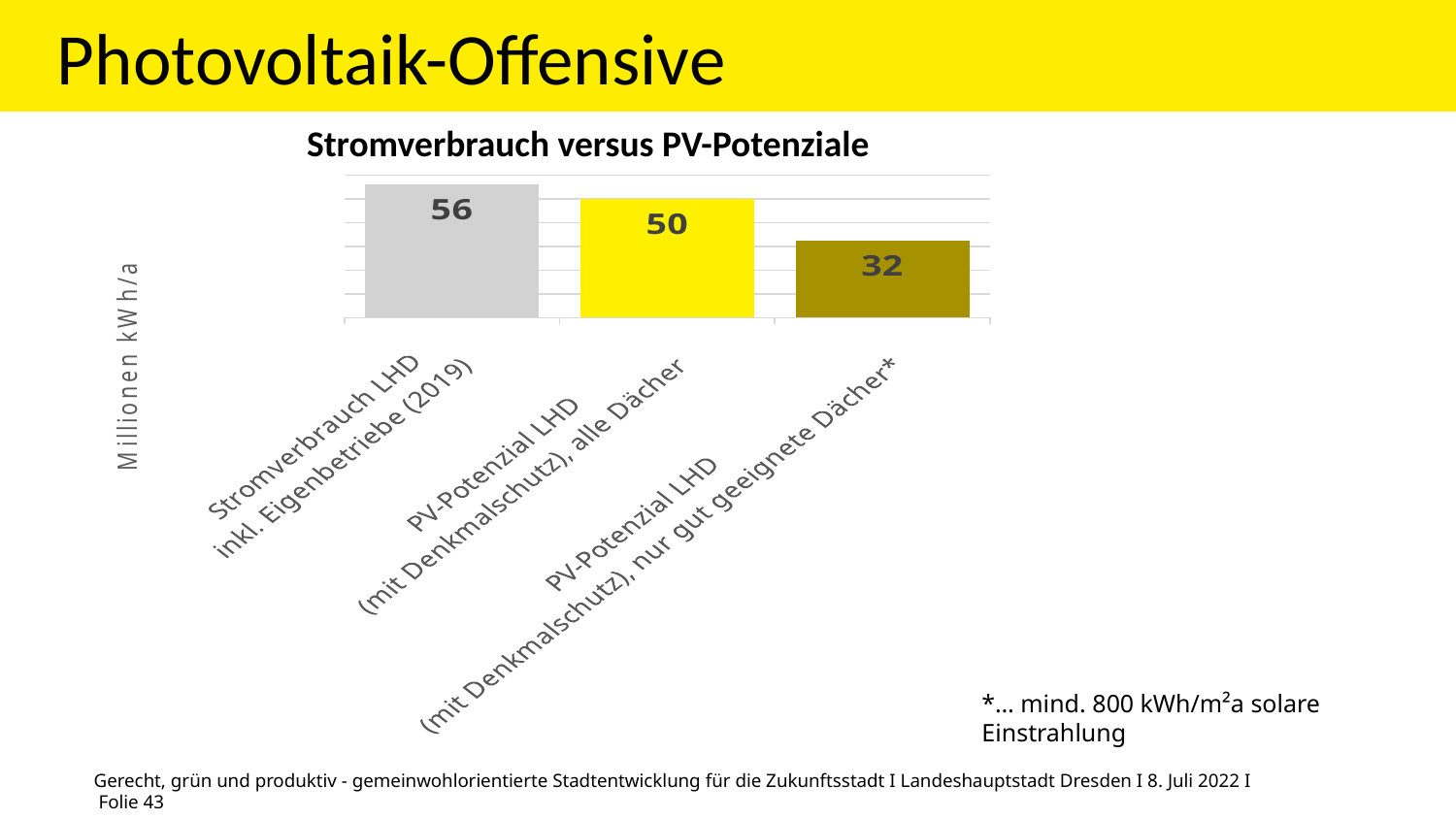
Which category has the lowest value? PV-Potenzial LHD (mit Denkmalschutz), nur gut geeignete Dächer* What is the difference between the value for 'PV-Potenzial LHD (mit Denkmalschutz), alle Dächer' and the value for 'PV-Potenzial LHD (mit Denkmalschutz), nur gut geeignete Dächer*'? 18 What is the value for 'PV-Potenzial LHD (mit Denkmalschutz), nur gut geeignete Dächer*'? 32 What kind of chart is shown on the slide? Bar chart How many categories are shown in the chart? 3 What is the difference between the value for 'Stromverbrauch LHD inkl. Eigenbetriebe (2019)' and the value for 'PV-Potenzial LHD (mit Denkmalschutz), alle Dächer'? 6 What is the value for 'PV-Potenzial LHD (mit Denkmalschutz), alle Dächer'? 50 Which is larger: the value for 'Stromverbrauch LHD inkl. Eigenbetriebe (2019)' or the value for 'PV-Potenzial LHD (mit Denkmalschutz), nur gut geeignete Dächer*'? Stromverbrauch LHD inkl. Eigenbetriebe (2019) Do the values rise or fall from left to right across the categories? Fall What is the title of the chart? Stromverbrauch versus PV-Potenziale What is the value for 'Stromverbrauch LHD inkl. Eigenbetriebe (2019)'? 56 Which category has the highest value? Stromverbrauch LHD inkl. Eigenbetriebe (2019)